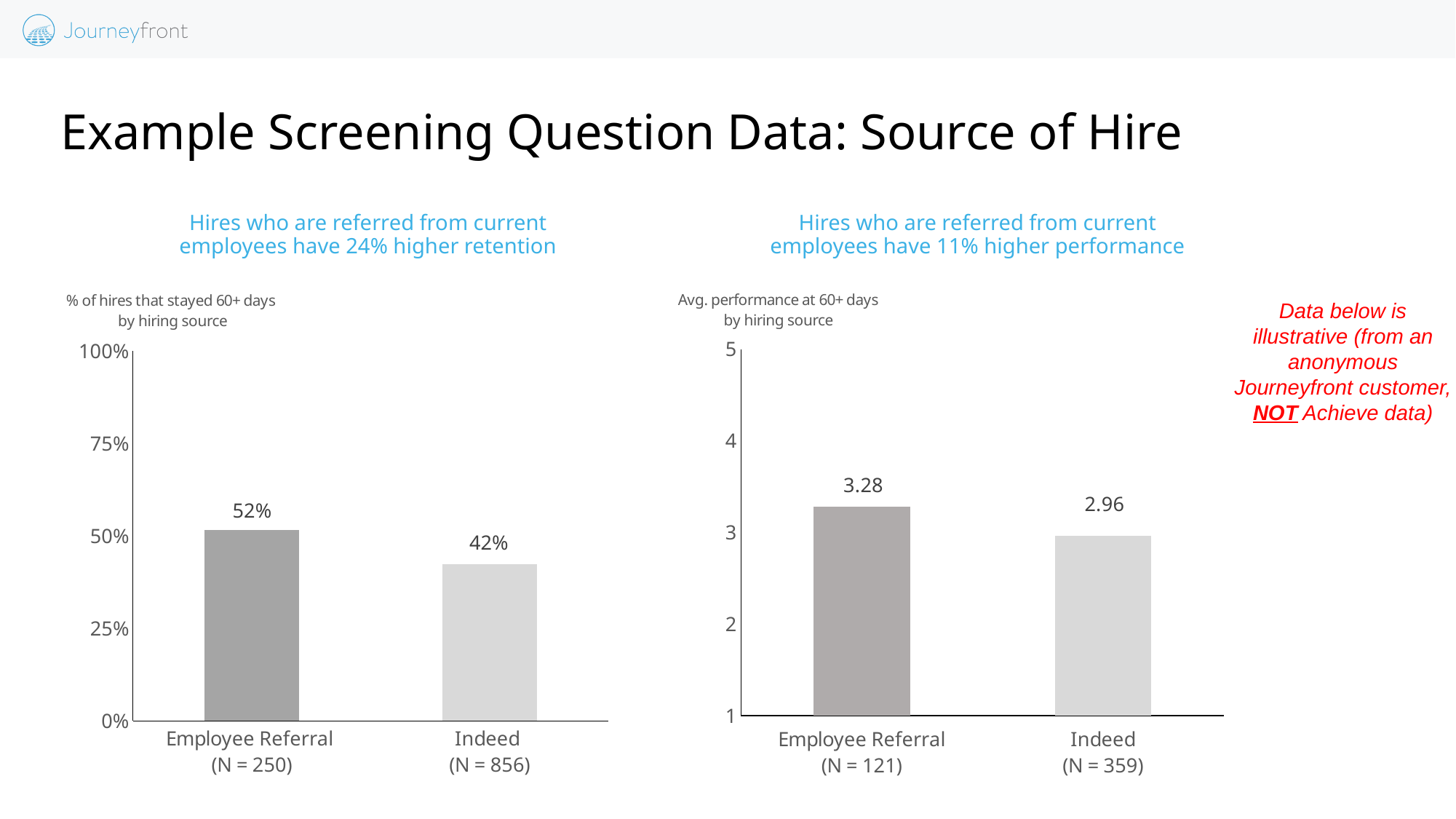
In the left chart (% of hires that stayed 60+ days by hiring source), what is the value for Employee Referral? 52% In the left chart (% of hires that stayed 60+ days by hiring source), what is the value for Indeed? 42% In the right chart (Avg. performance at 60+ days by hiring source), what is the value for Employee Referral? 3.28 In the right chart (Avg. performance at 60+ days by hiring source), what is the difference between the Employee Referral and Indeed values? 0.32 How many hiring source categories are shown in the left chart (% of hires that stayed 60+ days by hiring source)? 2 What kind of chart is the right chart (Avg. performance at 60+ days by hiring source)? Bar chart In the right chart (Avg. performance at 60+ days by hiring source), is the value for Employee Referral greater or less than 3? greater In the left chart (% of hires that stayed 60+ days by hiring source), what is the sample size (N) shown for Indeed? N = 856 In the right chart (Avg. performance at 60+ days by hiring source), which hiring source has the lowest value? Indeed In the left chart (% of hires that stayed 60+ days by hiring source), what is the difference between the Employee Referral and Indeed values? 10% In the left chart (% of hires that stayed 60+ days by hiring source), which hiring source has the highest value? Employee Referral In the right chart (Avg. performance at 60+ days by hiring source), what is the value for Indeed? 2.96